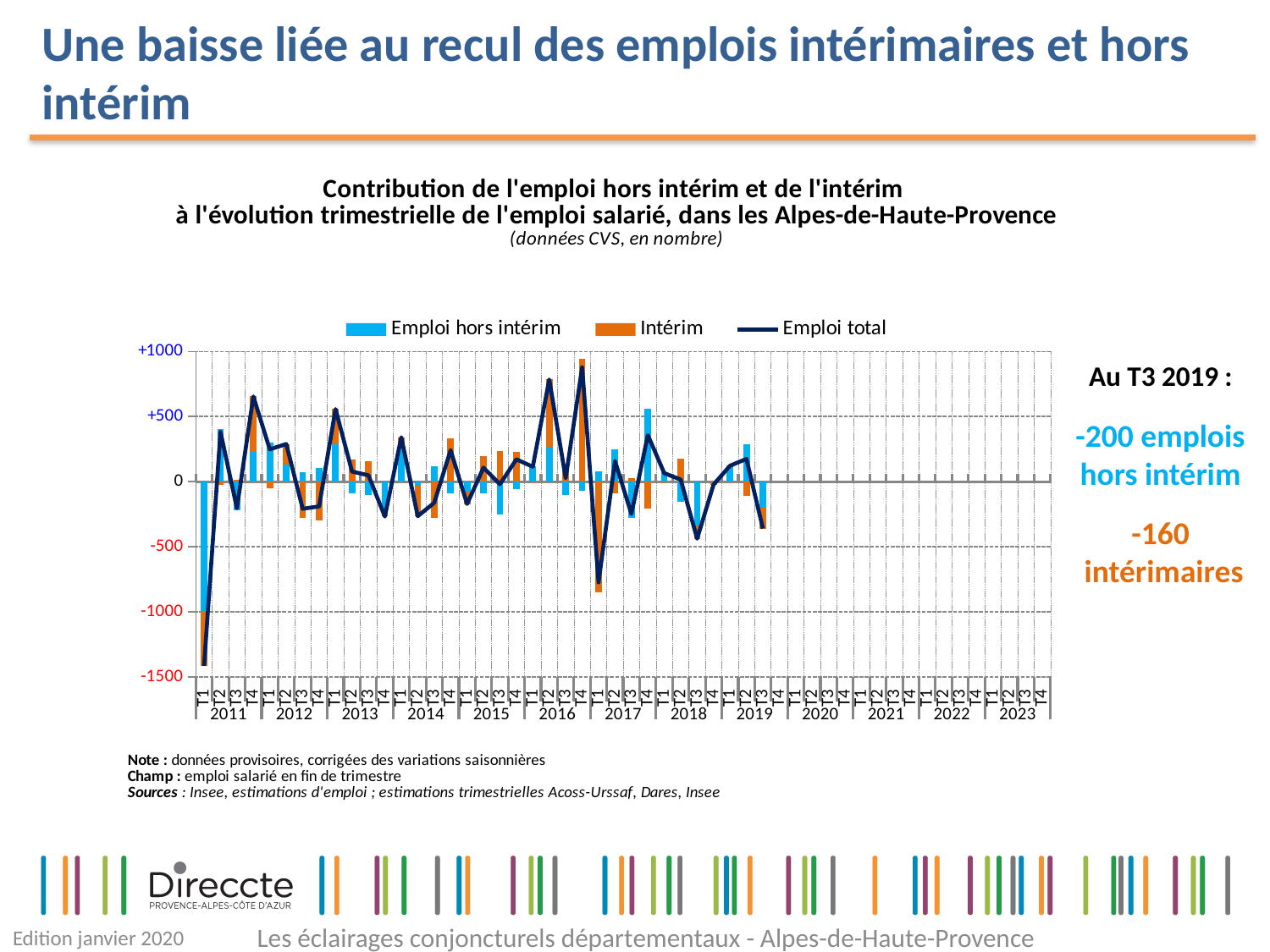
What is the sum of the Emploi hors intérim and Intérim contributions at T3 2019? -360 According to the slide, what is the value for Emploi hors intérim at T3 2019? -200 Is the Emploi total value at T1 2017 greater or less than -500? less How many series does the chart legend list? 3 Which series is drawn as a line rather than bars? Emploi total According to the slide, what is the value for Intérim at T3 2019? -160 Is the Intérim bar at T4 2016 greater or less than +500? greater At T3 2019, which contribution is larger in absolute terms: Emploi hors intérim or Intérim? Emploi hors intérim Is the Emploi total value at T1 2011 greater or less than -1000? less What is the difference between the Emploi hors intérim value (-200) and the Intérim value (-160) at T3 2019? 40 What kind of chart is shown on the slide? A combined bar and line chart In which quarter does the Emploi total line reach its lowest point? T1 2011